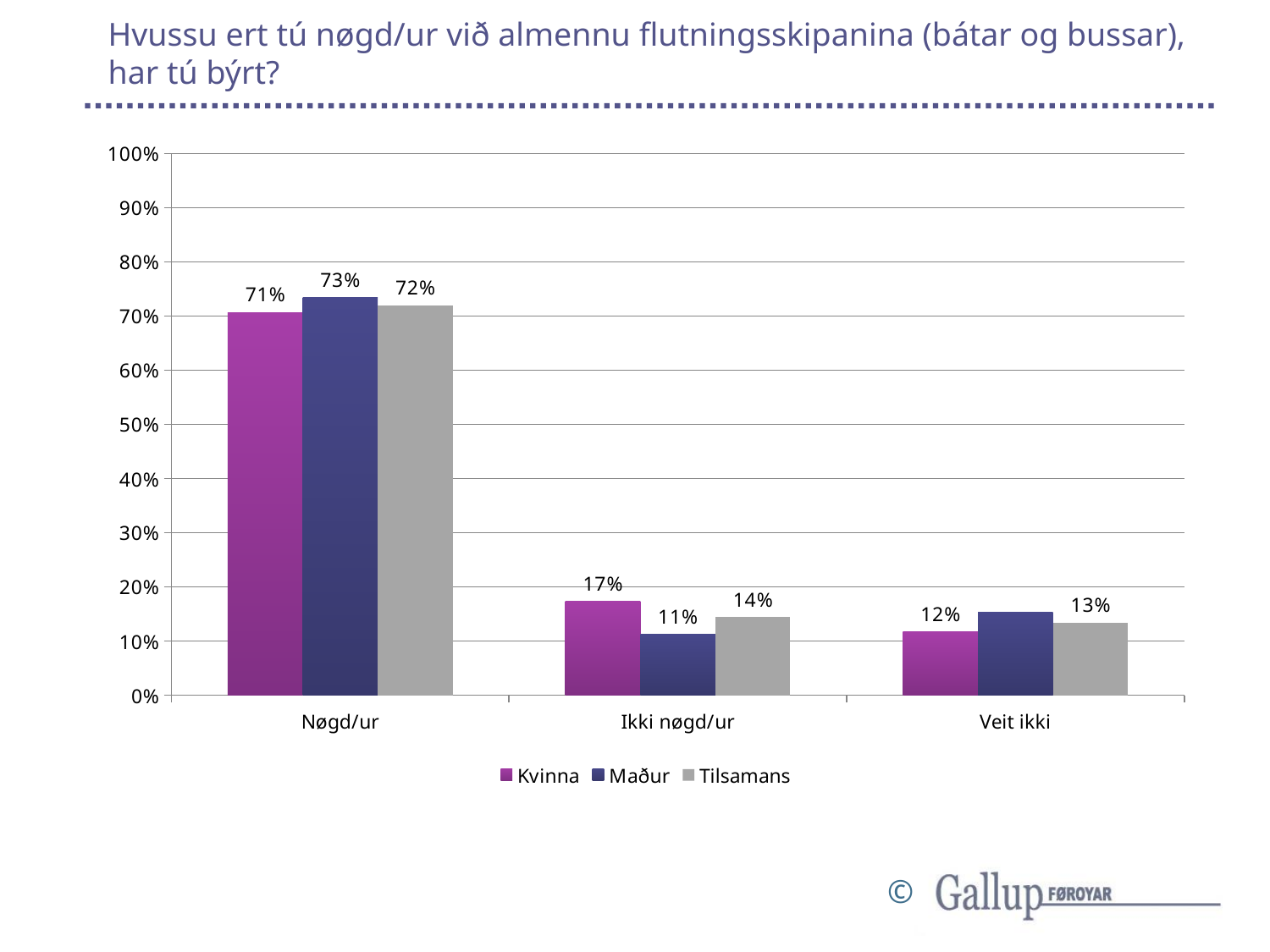
In the Nøgd/ur category, which is larger: the Kvinna value or the Tilsamans value? Tilsamans Which category has the highest value for the Tilsamans series? Nøgd/ur What is the value for Tilsamans in the Veit ikki category? 13% Which series is shown in purple in the legend? Kvinna How many series does the legend list? 3 What is the difference between the Kvinna and Maður values in the Ikki nøgd/ur category? 6 percentage points Which category has the lowest value for the Kvinna series? Veit ikki Is the value for Maður in the Veit ikki category greater or less than 10%? greater What is the value for Kvinna in the Nøgd/ur category? 71% How many categories are shown on the x axis? 3 What kind of chart is shown on the slide? bar chart What is the value for Maður in the Ikki nøgd/ur category? 11%